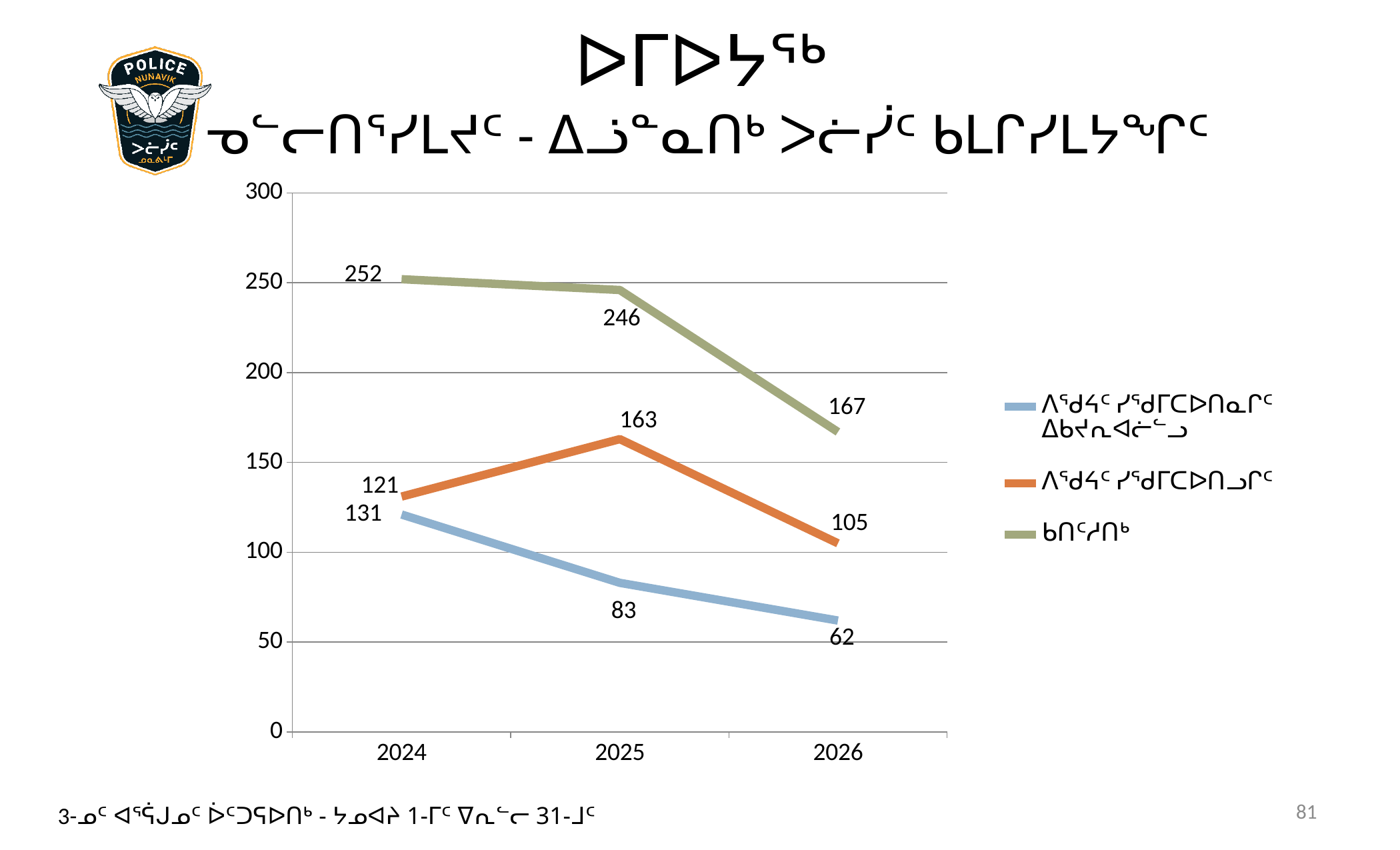
Does the green series rise or fall from 2024 to 2026? fall By how much does the green series fall from 2025 to 2026? 79 What kind of chart is shown on the slide? line chart What is the value of the green series in 2024? 252 How many series does the legend list? 3 In which year is the orange series at its lowest? 2026 What is the difference between the blue series values in 2025 and 2026? 21 What is the value of the blue series in 2026? 62 How many years are shown on the x axis? 3 What is the value of the green series in 2026? 167 What is the value of the orange series in 2025? 163 In 2025, which series is larger, the orange series or the blue series? orange